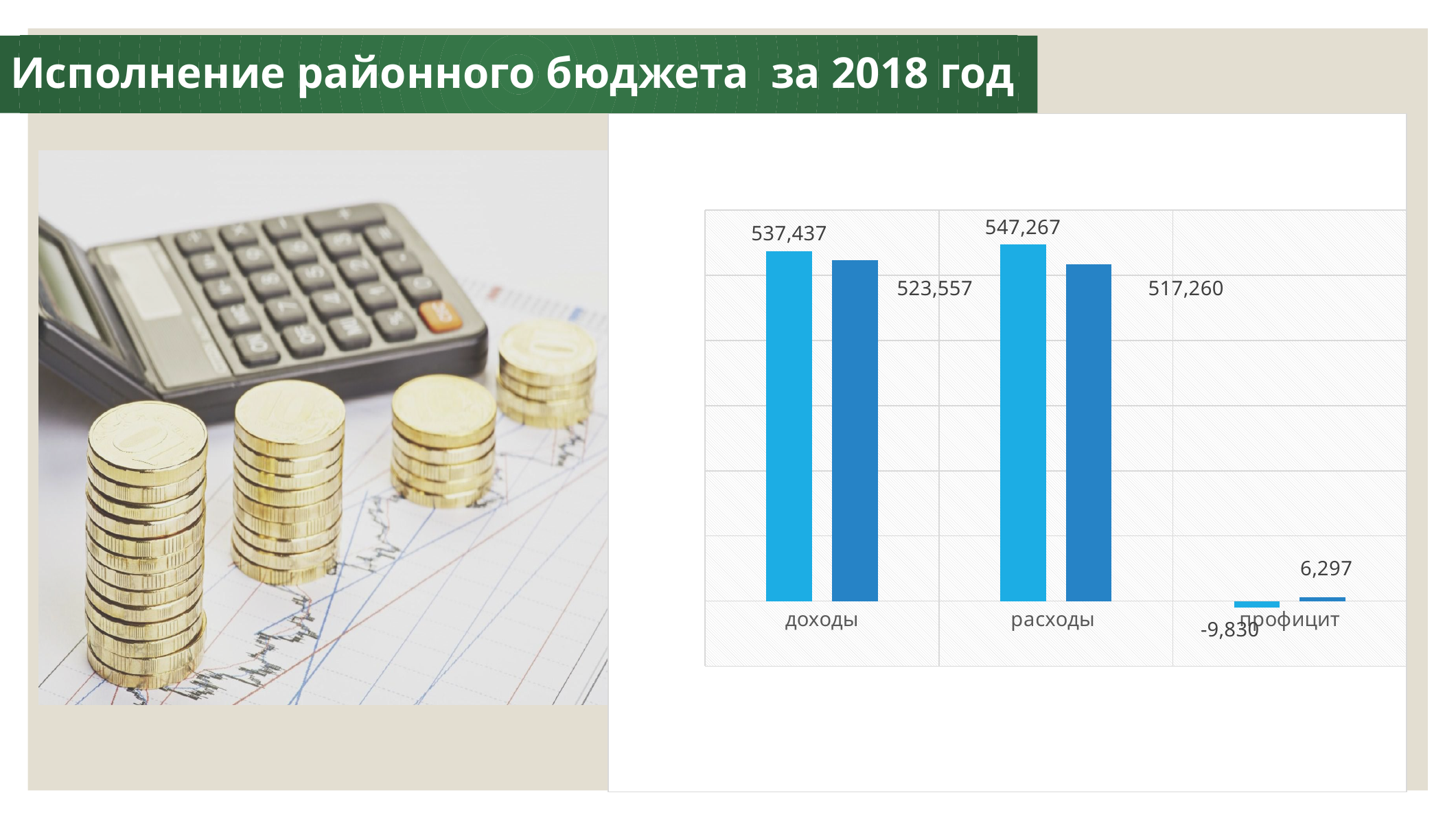
Among the lighter blue bars, which is larger: доходы or расходы? расходы What kind of chart is shown on the slide? bar chart What is the difference between the lighter blue bars for расходы and доходы? 9,830 What is the value of the darker blue bar for доходы? 523,557 What is the value of the lighter blue bar for расходы? 547,267 How many categories are shown on the x axis of the chart? 3 What is the value of the lighter blue bar for доходы? 537,437 What is the value of the darker blue bar for профицит? 6,297 What is the difference between the darker blue bars for доходы and расходы? 6,297 What is the value of the lighter blue bar for профицит? -9,830 What is the value of the darker blue bar for расходы? 517,260 Which category has the highest lighter blue bar? расходы